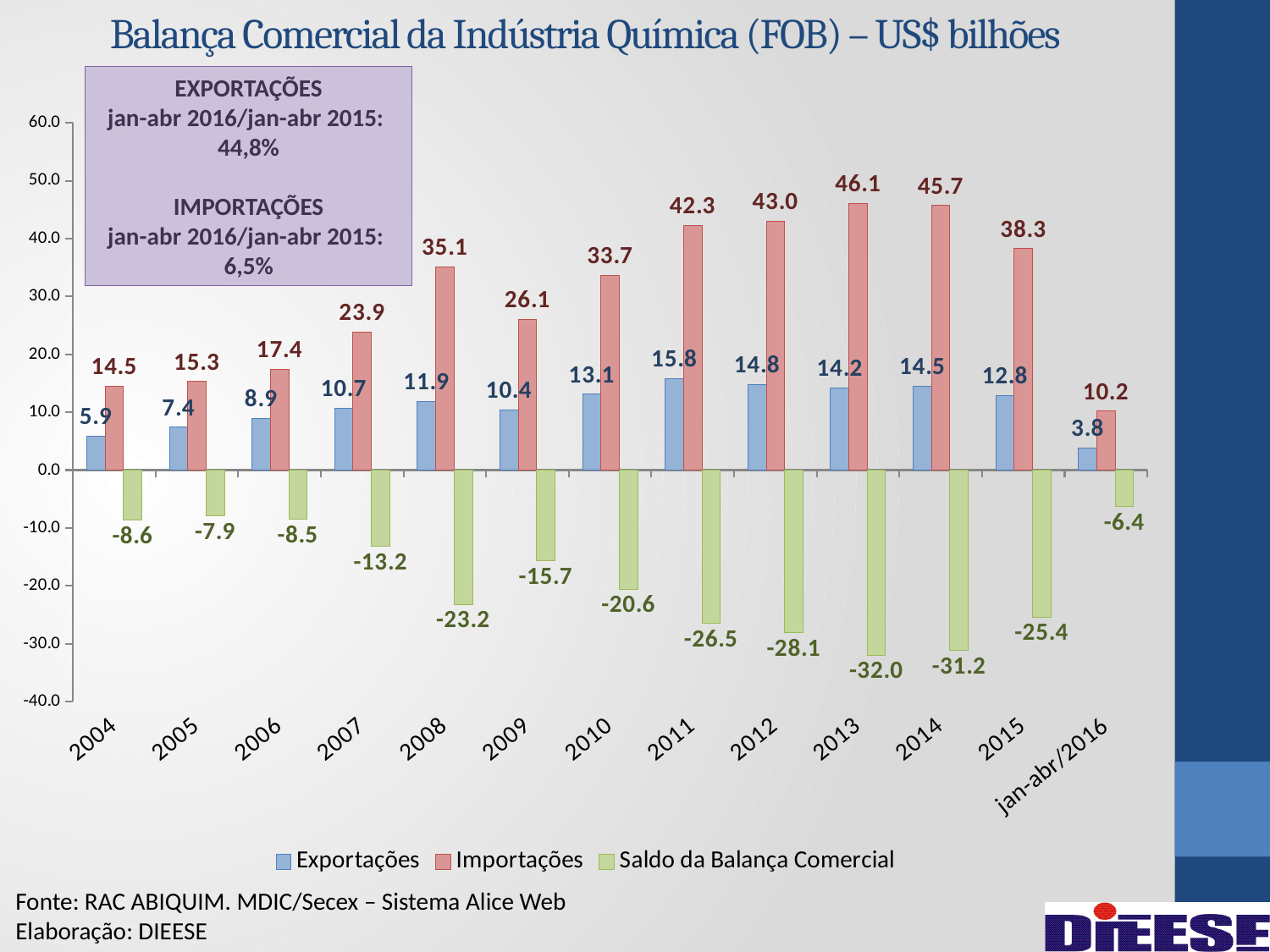
What is the value of Exportações in 2011? 15.8 What is the value of Importações in 2013? 46.1 Which is larger, Exportações in 2012 or Exportações in 2015? Exportações in 2012 How many categories are shown on the x axis? 13 What kind of chart is shown on the slide? bar chart Which category has the lowest Exportações value? jan-abr/2016 Which year has the highest Importações value? 2013 What is the difference between Importações and Exportações in 2014? 31.2 Do the Importações values rise or fall from 2004 to 2013? rise What is the title of the chart? Balança Comercial da Indústria Química (FOB) – US$ bilhões What is the Saldo da Balança Comercial for 2008? -23.2 How many series does the legend list? 3